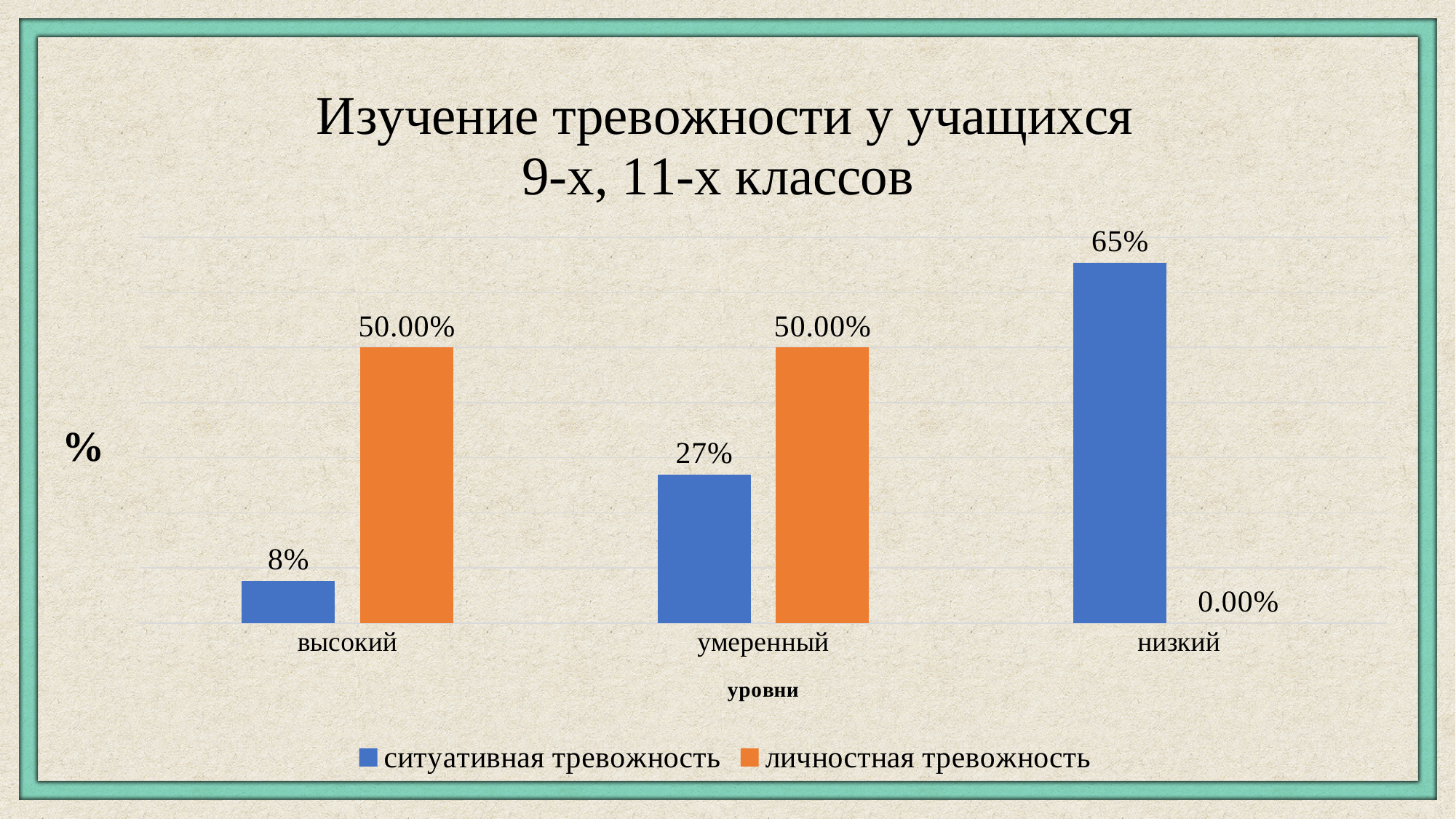
Which level has the highest value for ситуативная тревожность? низкий What is the label of the x axis? уровни What is the difference between the ситуативная тревожность values for низкий and высокий? 57% How many levels are shown on the x axis? 3 What kind of chart is shown on the slide? bar chart What is the value for личностная тревожность at the умеренный level? 50.00% What is the value for ситуативная тревожность at the высокий level? 8% At the умеренный level, which series has the larger value: ситуативная тревожность or личностная тревожность? личностная тревожность How many series does the legend list? 2 What is the value for личностная тревожность at the низкий level? 0.00% What is the value for ситуативная тревожность at the низкий level? 65% Which level has the lowest value for личностная тревожность? низкий